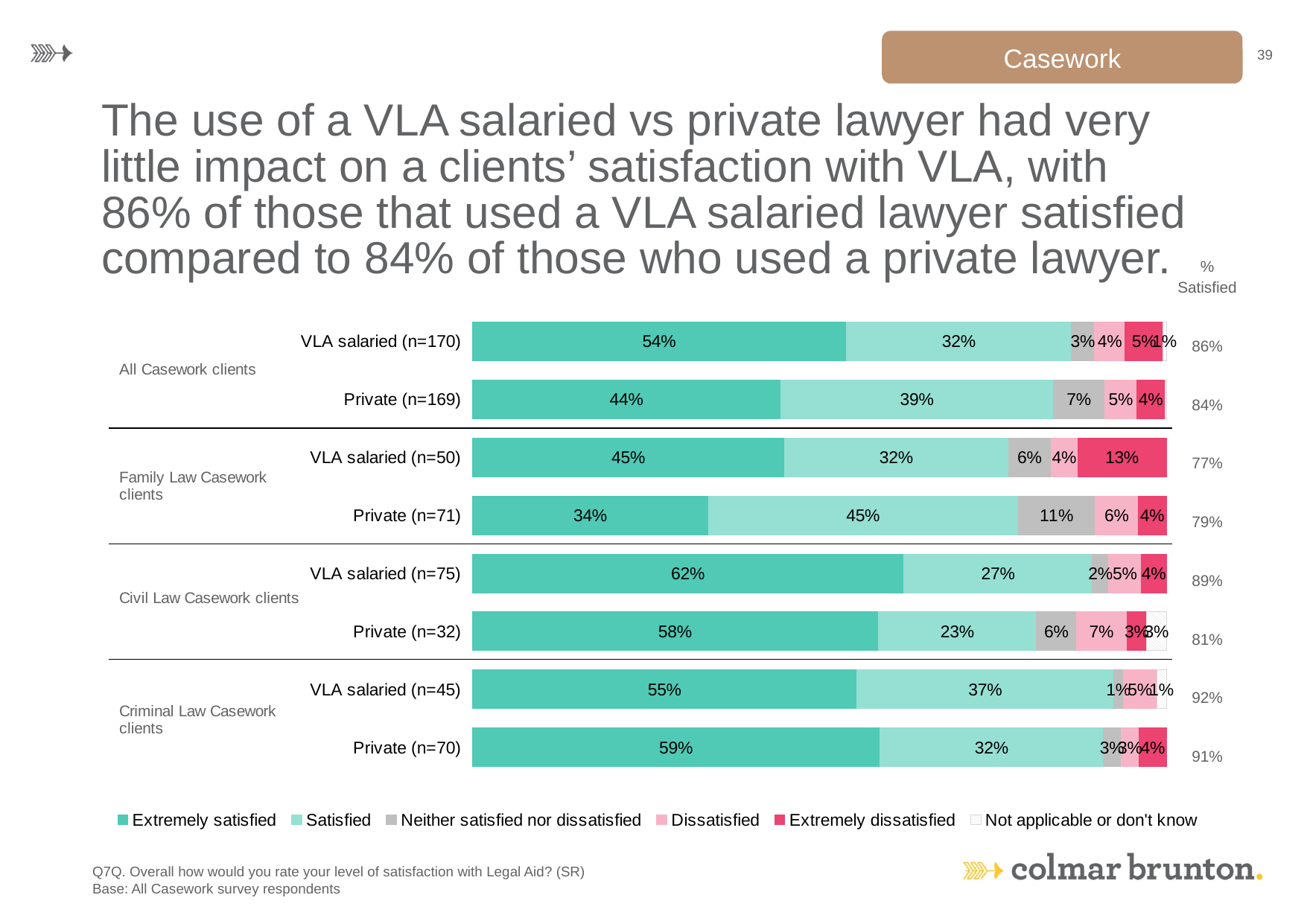
What is the % Satisfied figure for Criminal Law Casework clients with a VLA salaried lawyer (n=45)? 92% How many bars are shown in the chart? 8 What percentage of Private (n=169) clients were Satisfied? 39% What is the Extremely dissatisfied value for Family Law Casework clients with a VLA salaried lawyer (n=50)? 13% Which bar has the lowest Extremely satisfied percentage? Family Law Casework clients, Private (n=71) Which group has the lowest % Satisfied figure? Family Law Casework clients, VLA salaried (n=50) What type of chart is shown on the slide? Stacked bar chart Among Family Law Casework clients, which has the larger Satisfied percentage: VLA salaried (n=50) or Private (n=71)? Private (n=71) Which bar has the highest Extremely satisfied percentage? Civil Law Casework clients, VLA salaried (n=75) How many series does the legend list? 6 What percentage of VLA salaried (n=170) clients were Extremely satisfied? 54% What is the difference in % Satisfied between All Casework clients with a VLA salaried lawyer and those with a Private lawyer? 2 percentage points